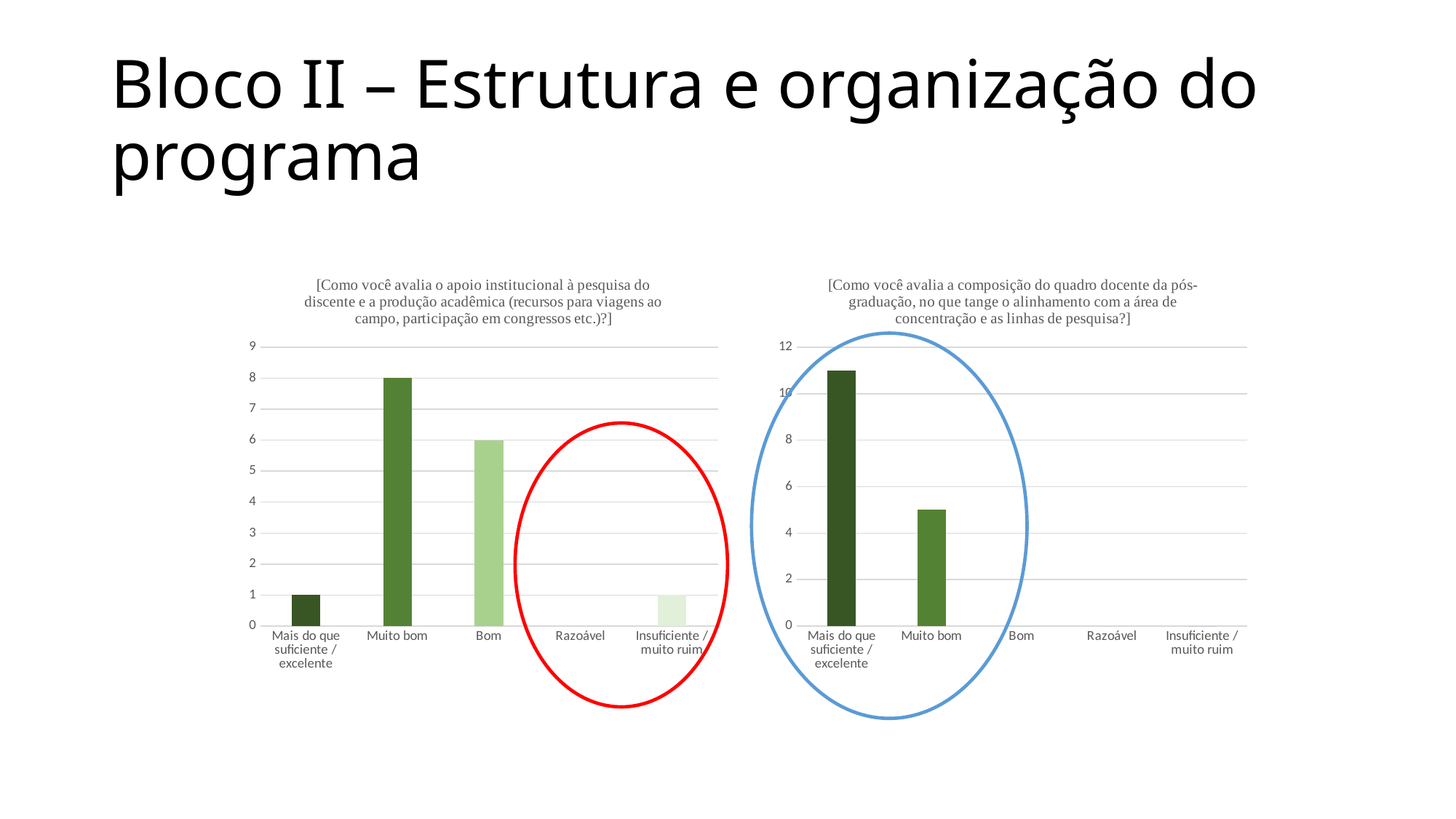
In the left chart (apoio institucional à pesquisa), what is the value for 'Mais do que suficiente / excelente'? 1 In the right chart (composição do quadro docente), which category has the highest value? Mais do que suficiente / excelente In the left chart (apoio institucional à pesquisa), what is the value for 'Bom'? 6 In the right chart (composição do quadro docente), which is larger: 'Mais do que suficiente / excelente' or 'Muito bom'? Mais do que suficiente / excelente In the right chart (composição do quadro docente), is the value for 'Muito bom' greater or less than 6? less In the left chart (apoio institucional à pesquisa), what is the difference between 'Muito bom' and 'Bom'? 2 In the right chart (composição do quadro docente), is the value for 'Mais do que suficiente / excelente' greater or less than 10? greater In the left chart (apoio institucional à pesquisa), what is the value for 'Muito bom'? 8 What colour is the ellipse drawn around the right chart? Blue What type of chart is the left chart (apoio institucional à pesquisa)? Bar chart In the left chart (apoio institucional à pesquisa), which category has the highest value? Muito bom In the left chart (apoio institucional à pesquisa), how many categories are shown on the x axis? 5